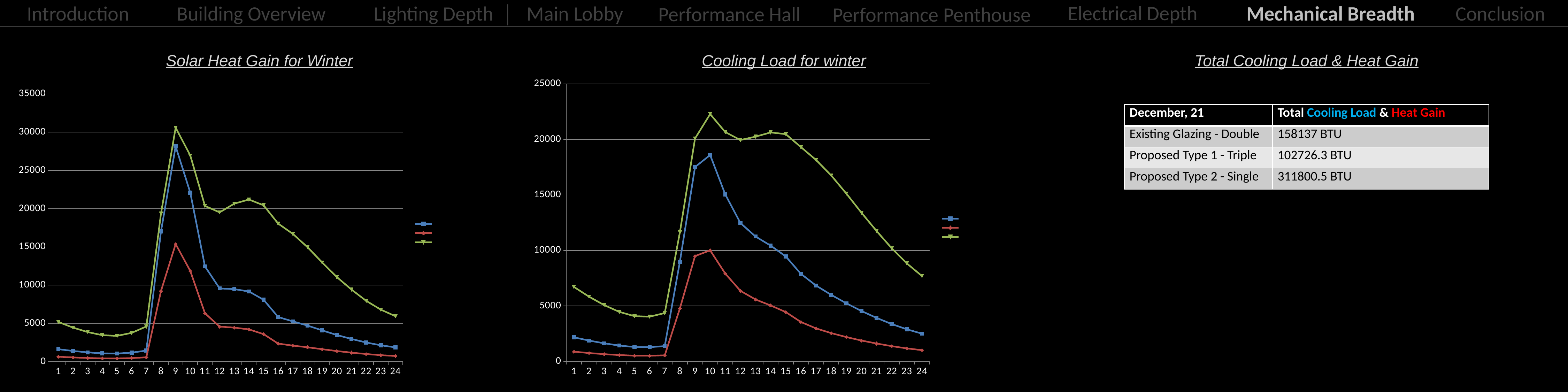
How many points are plotted along the x axis of the 'Cooling Load for winter' chart? 24 In the 'Cooling Load for winter' chart, at which hour does the green series reach its highest value? 10 In the 'Solar Heat Gain for Winter' chart, at which hour does the green series reach its highest value? 9 In the 'Cooling Load for winter' chart, which series is higher at hour 15, the green series or the blue series? green What is the highest tick value shown on the y axis of the 'Cooling Load for winter' chart? 25000 In the 'Cooling Load for winter' chart, is the value of the blue series at hour 10 greater or less than 20000? less In the 'Solar Heat Gain for Winter' chart, is the value of the blue series at hour 9 greater or less than 25000? greater How many series does the legend of the 'Solar Heat Gain for Winter' chart list? 3 In the 'Cooling Load for winter' chart, is the value of the green series at hour 10 greater or less than 20000? greater In the 'Solar Heat Gain for Winter' chart, which series is higher at hour 9, the green series or the red series? green In the 'Solar Heat Gain for Winter' chart, does the blue series rise or fall from hour 10 to hour 24? fall What kind of chart is the 'Solar Heat Gain for Winter' chart? line chart